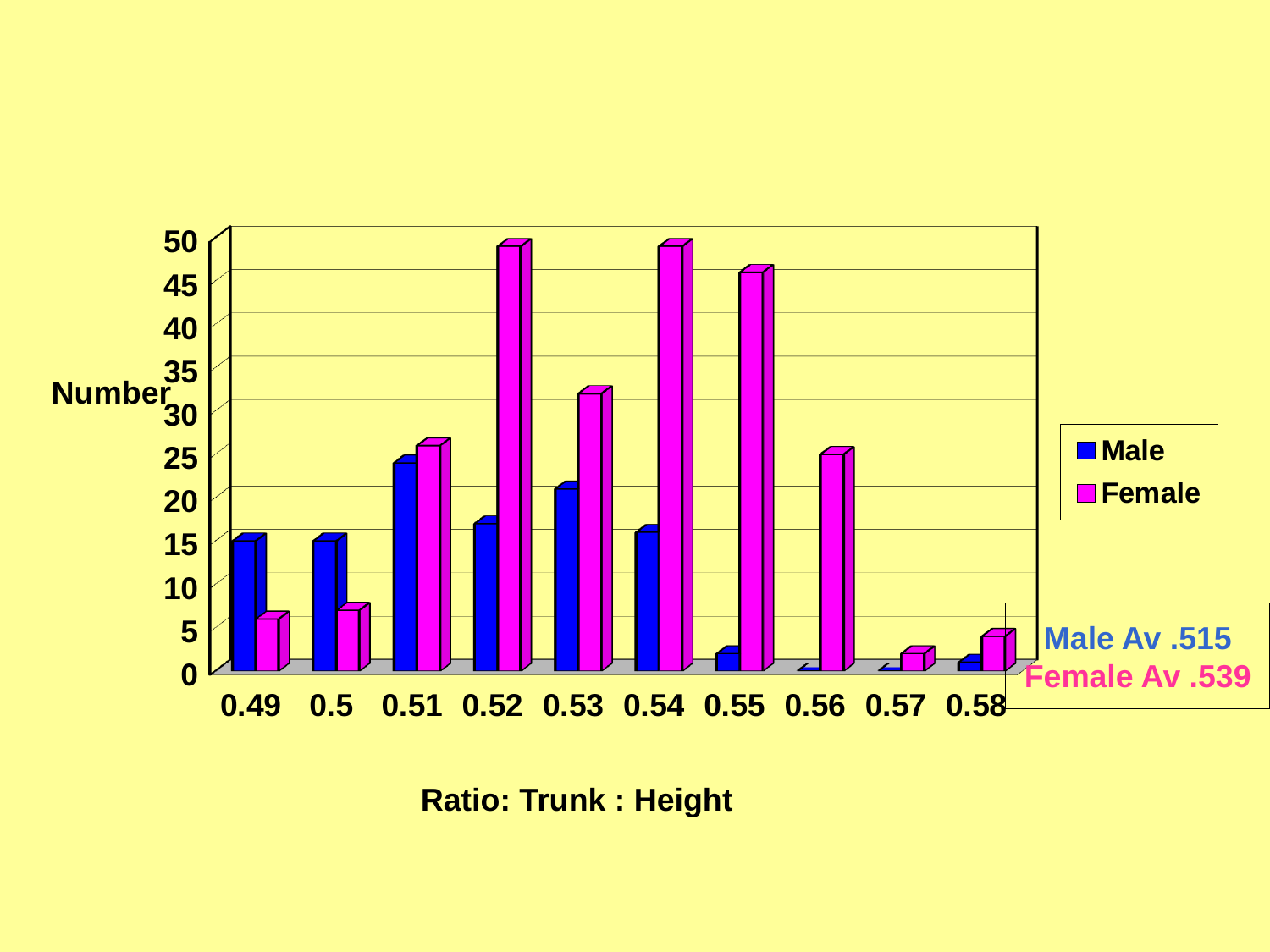
Is the Female value at ratio 0.52 greater or less than 45? greater Which is larger at ratio 0.53, the Male value or the Female value? Female What kind of chart is shown on the slide? bar chart Is the Female value at ratio 0.56 greater or less than 20? greater At which ratio is the Male value highest? 0.51 What is the label on the horizontal axis? Ratio: Trunk : Height How many ratio categories are shown along the x axis? 10 What is the label on the vertical axis? Number How many series does the legend list? 2 Is the Male value at ratio 0.55 greater or less than 5? less Which is larger at ratio 0.5, the Male value or the Female value? Male